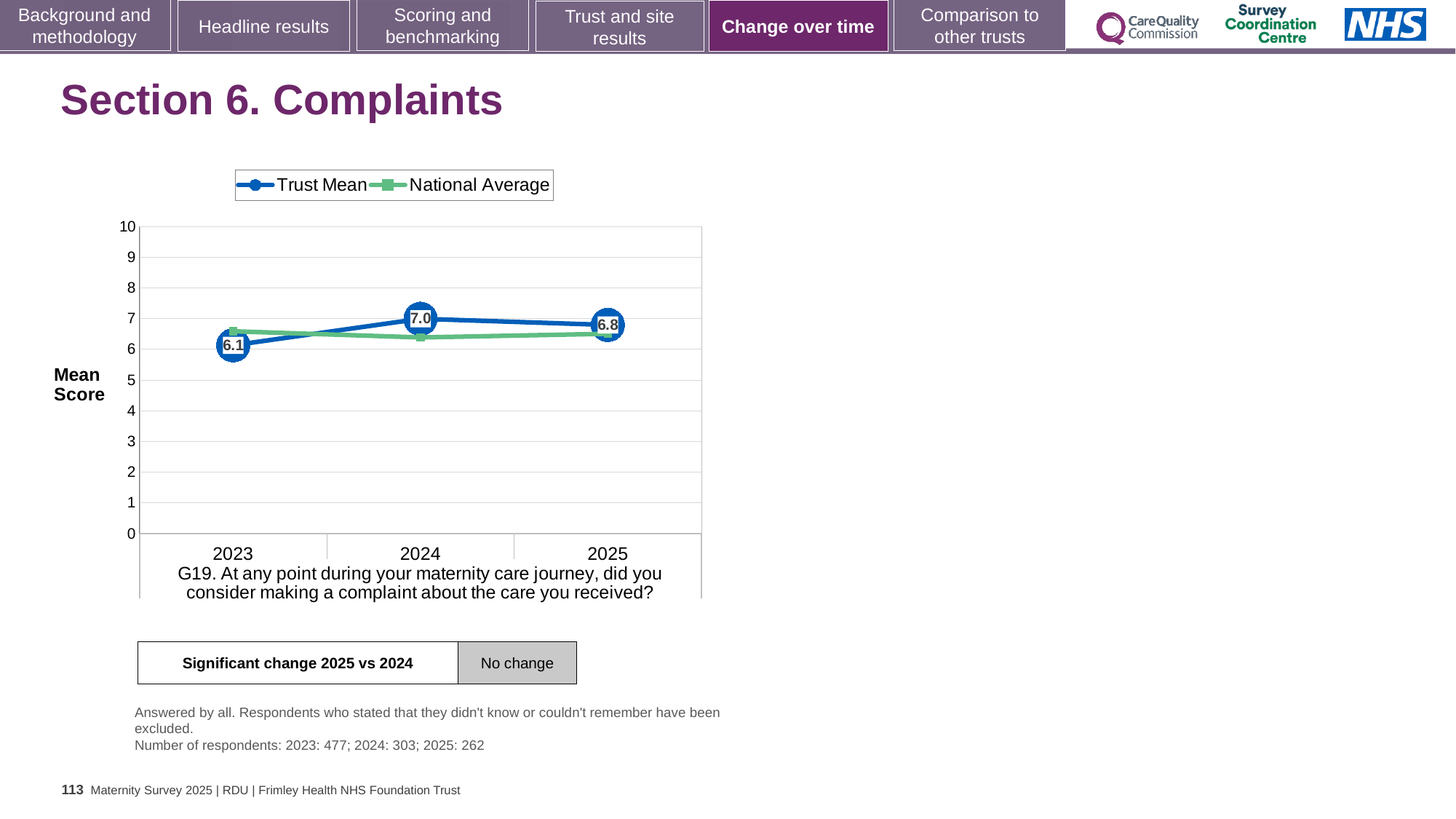
In which year is the Trust Mean score highest? 2024 How many series does the chart legend list? 2 How many years are shown on the x axis of the chart? 3 In which year is the Trust Mean score lowest? 2023 What is the Trust Mean score for 2024? 7.0 What is the difference between the Trust Mean scores for 2024 and 2023? 0.9 What kind of chart is shown on the slide? Line chart Is the National Average value for 2023 greater or less than 7? less Does the Trust Mean score rise or fall from 2023 to 2024? Rise What is the Trust Mean score for 2025? 6.8 What is the Trust Mean score for 2023? 6.1 Which year has the larger Trust Mean score, 2024 or 2025? 2024